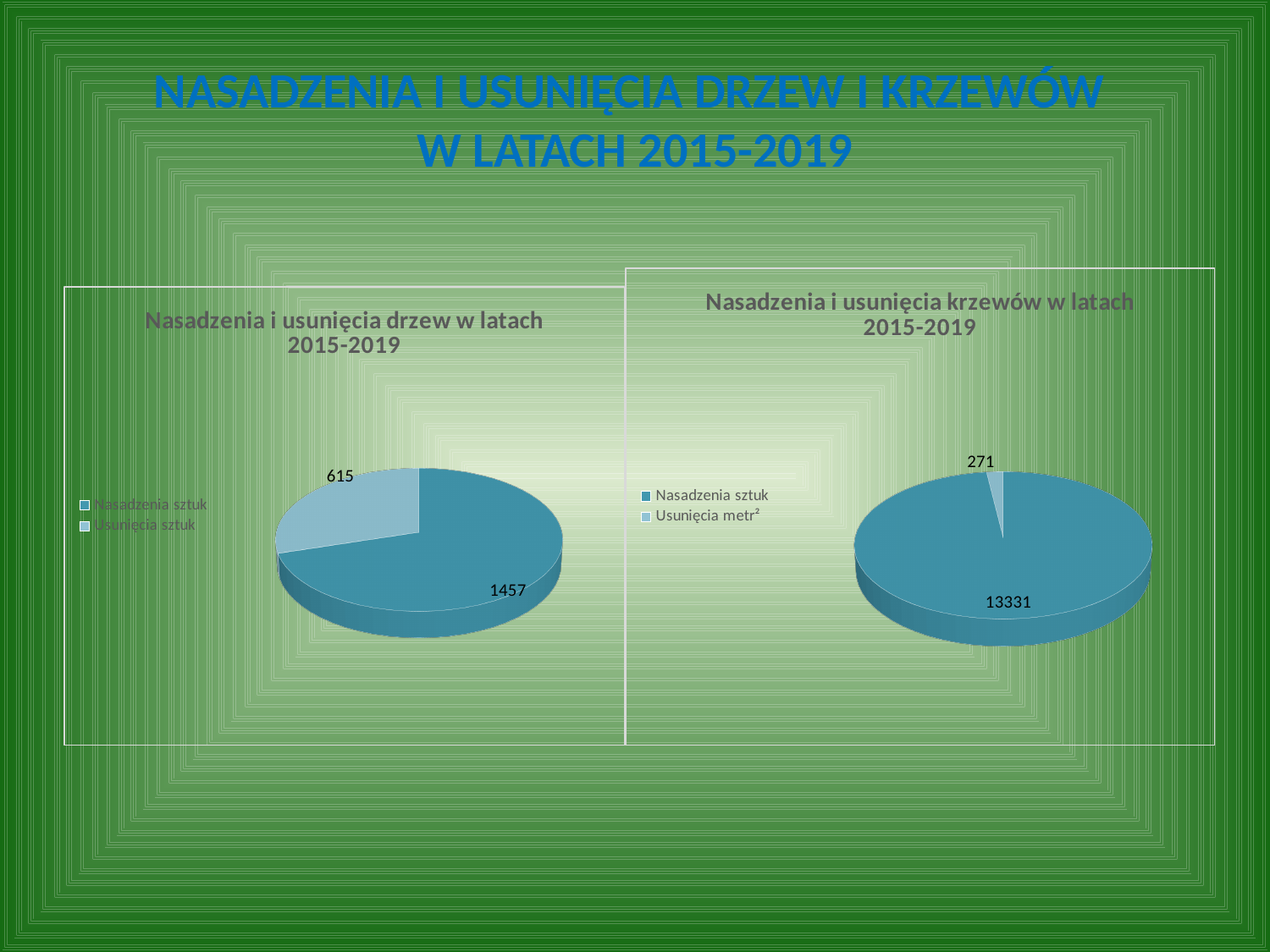
How many entries does the legend of the right chart, 'Nasadzenia i usunięcia krzewów w latach 2015-2019', list? 2 In the left chart, 'Nasadzenia i usunięcia drzew w latach 2015-2019', what is the value for Nasadzenia sztuk? 1457 In the right chart, 'Nasadzenia i usunięcia krzewów w latach 2015-2019', what is the value for Nasadzenia sztuk? 13331 How many slices does the left chart, 'Nasadzenia i usunięcia drzew w latach 2015-2019', have? 2 In the left chart, 'Nasadzenia i usunięcia drzew w latach 2015-2019', what is the value for Usunięcia sztuk? 615 In the right chart, 'Nasadzenia i usunięcia krzewów w latach 2015-2019', what is the difference between Nasadzenia sztuk and Usunięcia metr²? 13060 In the right chart, 'Nasadzenia i usunięcia krzewów w latach 2015-2019', what is the value for Usunięcia metr²? 271 In the left chart, 'Nasadzenia i usunięcia drzew w latach 2015-2019', what is the difference between Nasadzenia sztuk and Usunięcia sztuk? 842 In the right chart, 'Nasadzenia i usunięcia krzewów w latach 2015-2019', which slice is the smallest? Usunięcia metr² In the left chart, 'Nasadzenia i usunięcia drzew w latach 2015-2019', which is larger: Nasadzenia sztuk or Usunięcia sztuk? Nasadzenia sztuk What kind of chart is the right chart, 'Nasadzenia i usunięcia krzewów w latach 2015-2019'? Pie chart In the left chart, 'Nasadzenia i usunięcia drzew w latach 2015-2019', which slice is the largest? Nasadzenia sztuk